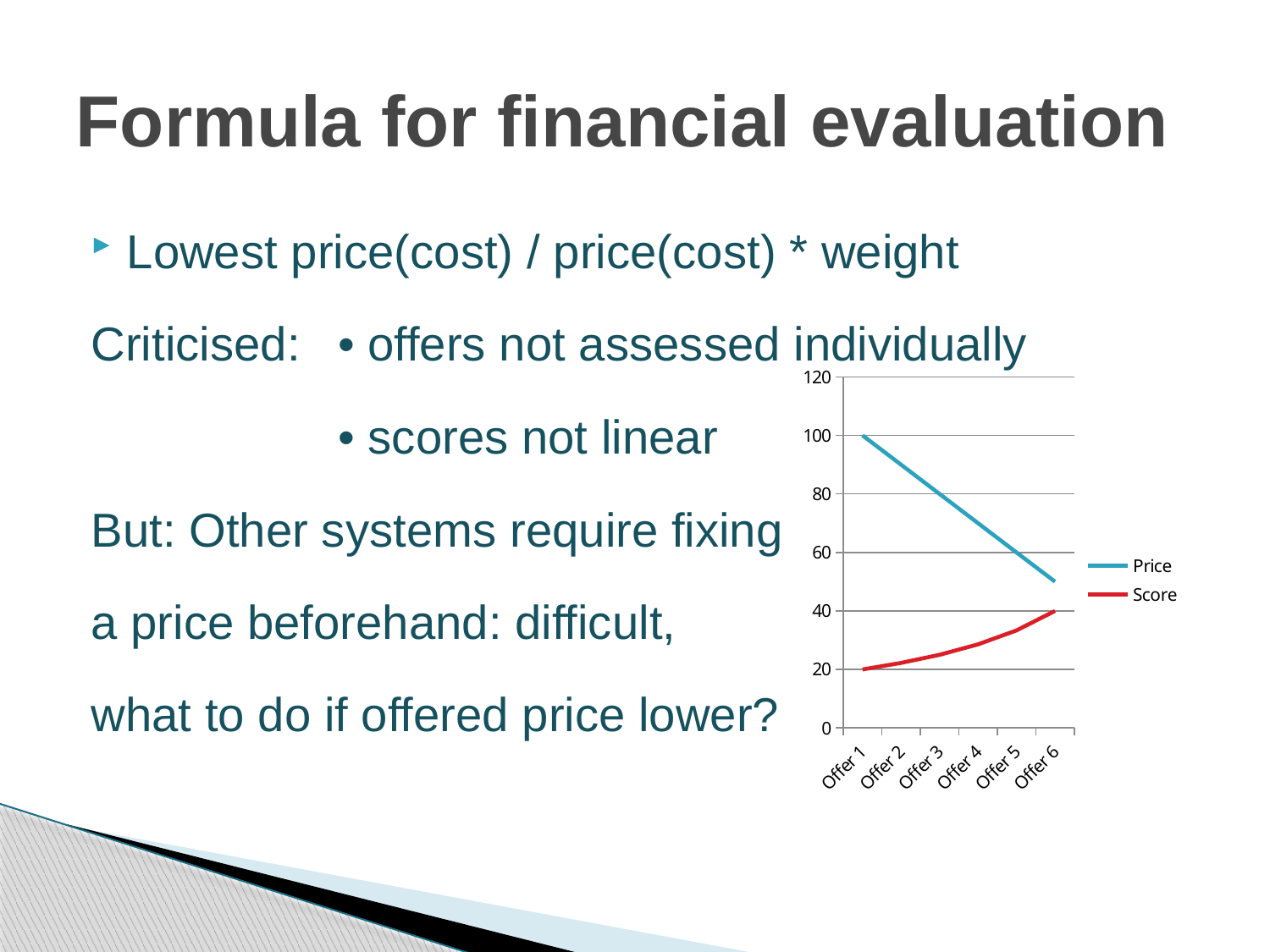
By how much does the Score for Offer 6 exceed the Score for Offer 1? 20 What is the Price value for Offer 1? 100 How many offers are shown along the x axis of the chart? 6 What is the Score value for Offer 1? 20 For which offer is the Price series highest? Offer 1 Does the Score series rise or fall from Offer 1 to Offer 6? Rise How many series does the chart's legend list? 2 Which series is drawn in red in the chart? Score Does the Price series rise or fall from Offer 1 to Offer 6? Fall What kind of chart is shown on the slide? Line chart What is the Score value for Offer 6? 40 Is the Price value for Offer 6 greater or less than 60? less